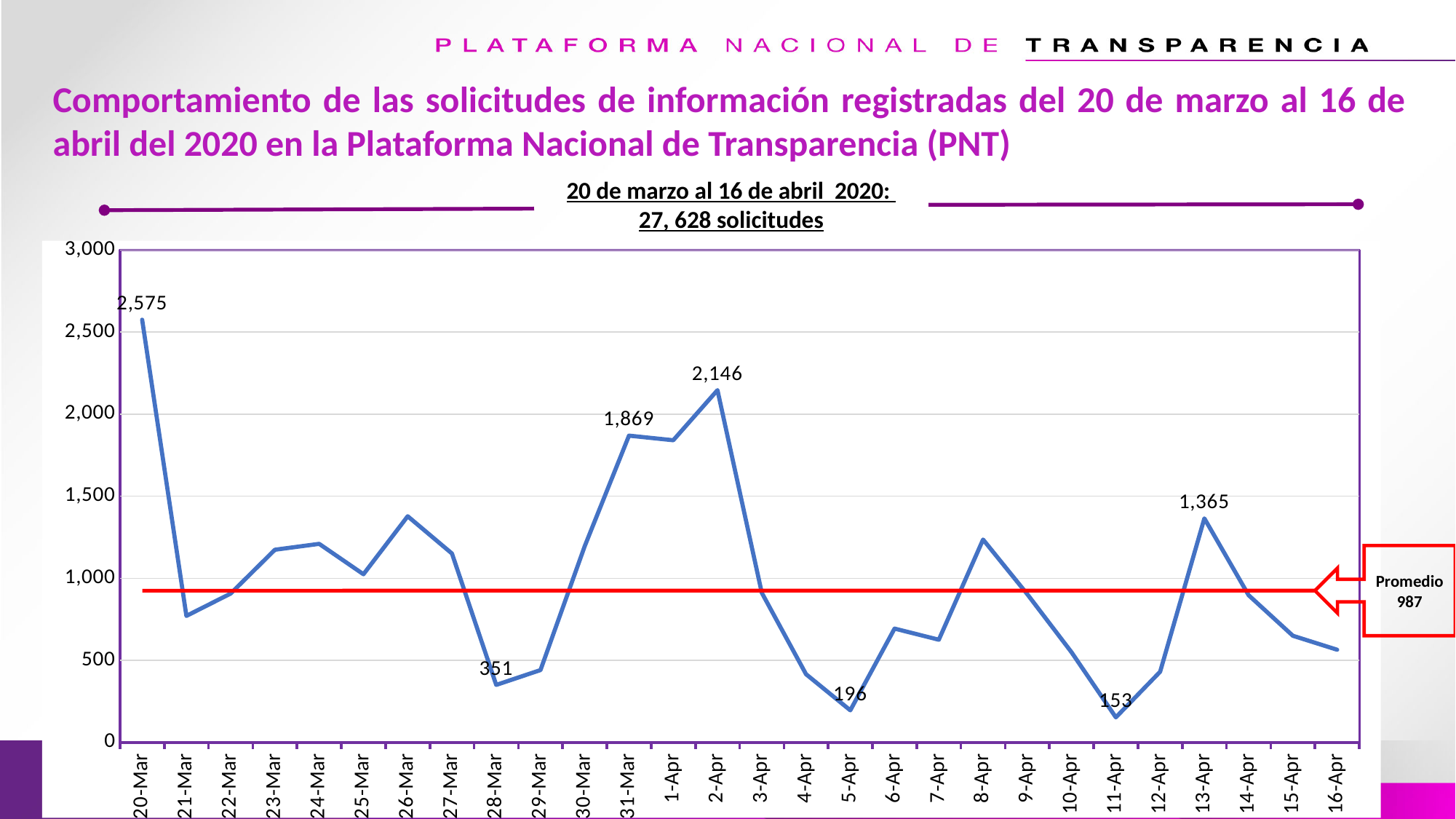
What is the value for 20-Mar? 2,575 Which date has the lowest value? 11-Apr What is the value for 28-Mar? 351 What is the value for 11-Apr? 153 Is the value for 21-Mar greater or less than 1,000? less What is the difference between the values for 20-Mar and 2-Apr? 429 Which date has the highest value? 20-Mar Which is larger, the value for 31-Mar or the value for 13-Apr? 31-Mar What kind of chart is this? line chart Is the value for 8-Apr greater or less than 1,000? greater How many dates are shown on the x axis? 28 What is the value for 2-Apr? 2,146